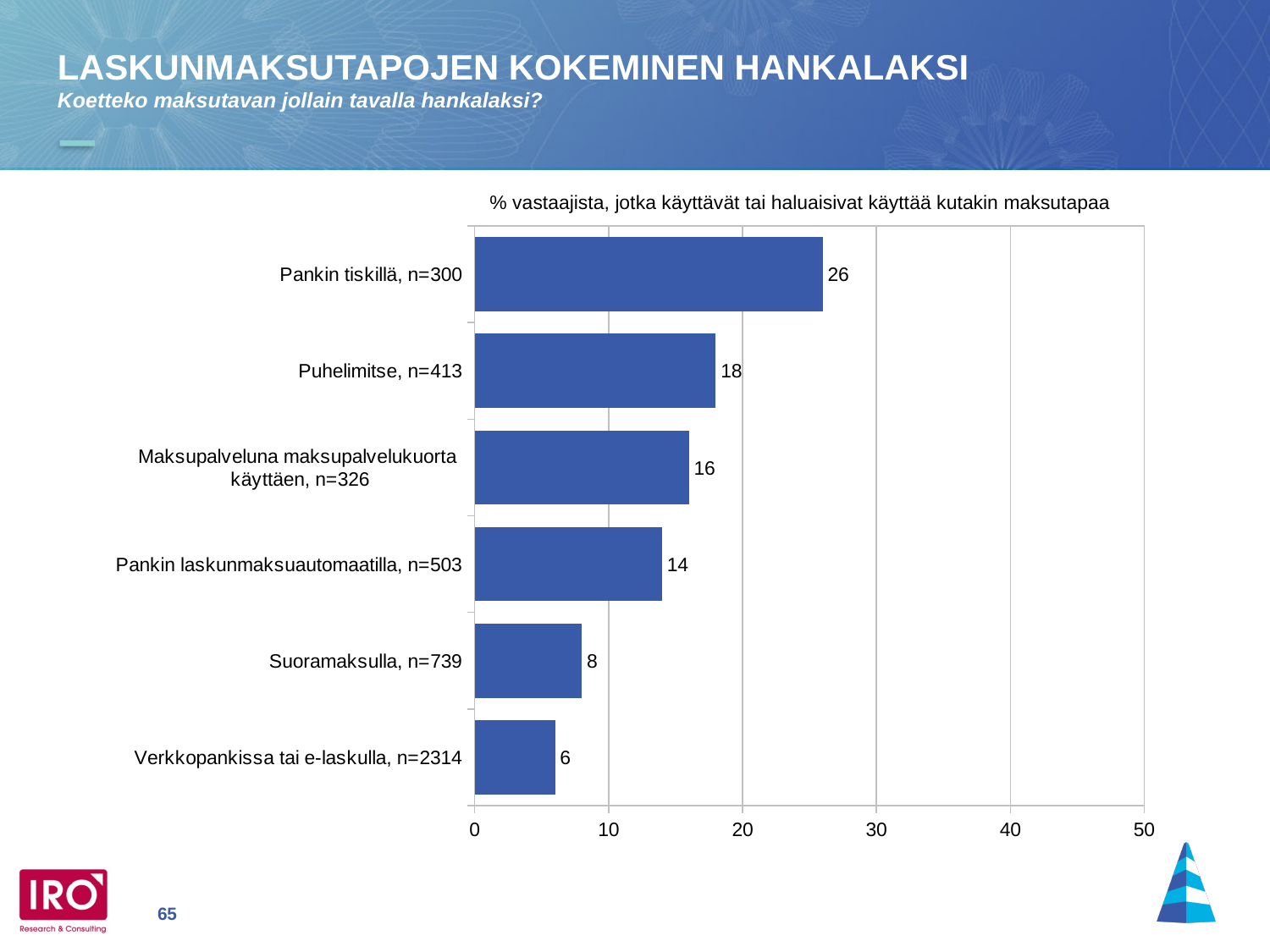
Which category has the highest value? Pankin tiskillä, n=300 What is the difference between the values for Pankin tiskillä, n=300 and Puhelimitse, n=413? 8 What kind of chart is shown on the slide? bar chart What is the value for Puhelimitse, n=413? 18 Which category has the lowest value? Verkkopankissa tai e-laskulla, n=2314 Is the value for Pankin tiskillä, n=300 greater or less than 20? greater What is the title of the chart? % vastaajista, jotka käyttävät tai haluaisivat käyttää kutakin maksutapaa What is the value for Verkkopankissa tai e-laskulla, n=2314? 6 Which is larger: the value for Maksupalveluna maksupalvelukuorta käyttäen, n=326 or Pankin laskunmaksuautomaatilla, n=503? Maksupalveluna maksupalvelukuorta käyttäen, n=326 What is the value for Suoramaksulla, n=739? 8 How many categories are shown in the chart? 6 What is the value for Pankin tiskillä, n=300? 26